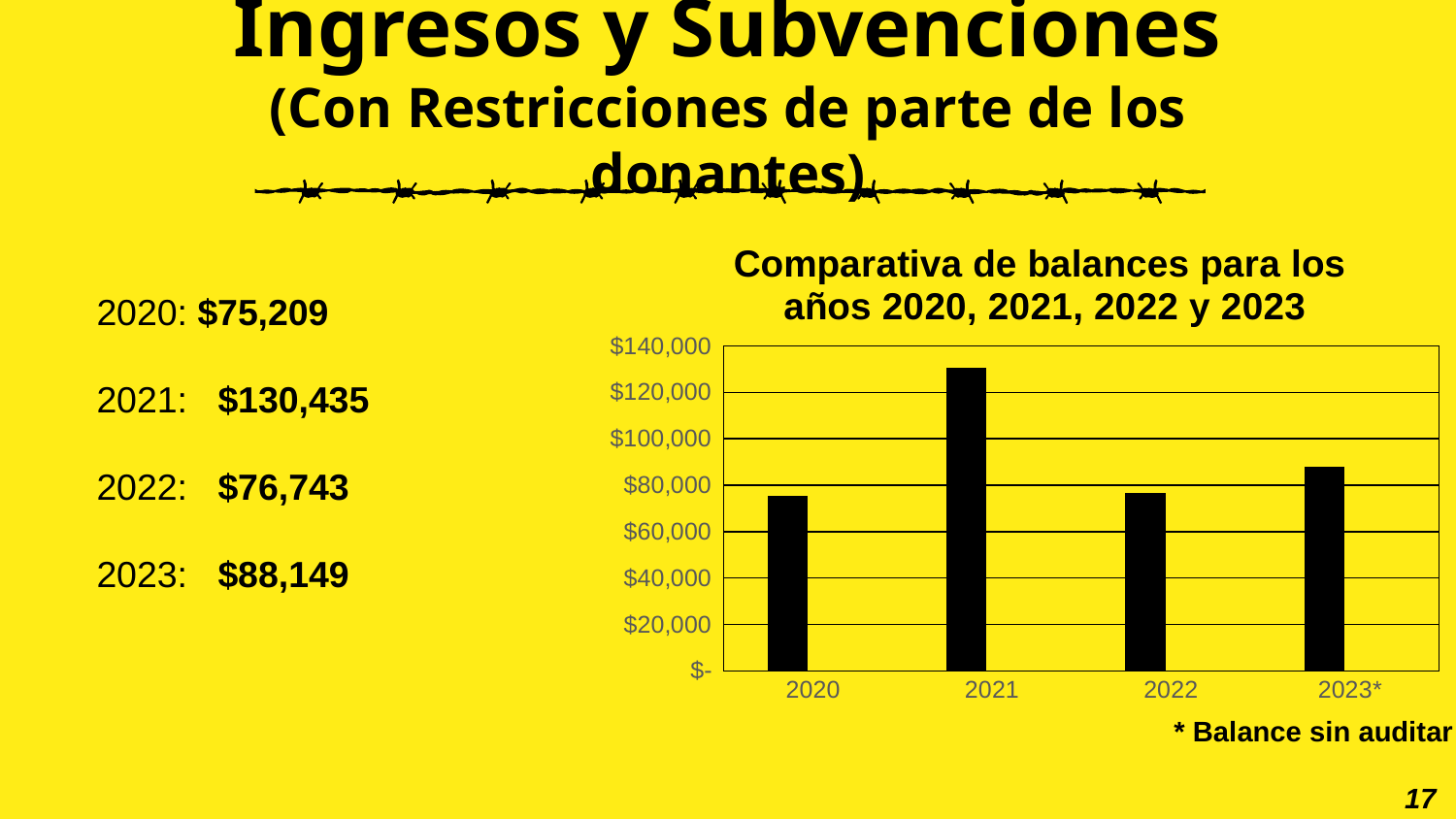
Is the value for 2022 greater or less than $80,000? less How many bars are shown in the chart? 4 Which year has the highest bar in the chart? 2021 What kind of chart is shown on the slide? bar chart What is the difference between the values for 2023 and 2022? $11,406 What is the title of the chart? Comparativa de balances para los años 2020, 2021, 2022 y 2023 Which year has the lowest value in the chart? 2020 What is the value for 2023 in the chart? $88,149 Is the value for 2021 greater or less than $120,000? greater What is the difference between the values for 2021 and 2020? $55,226 Which is larger, the value for 2023 or the value for 2022? 2023 What is the value for 2021 in the chart? $130,435